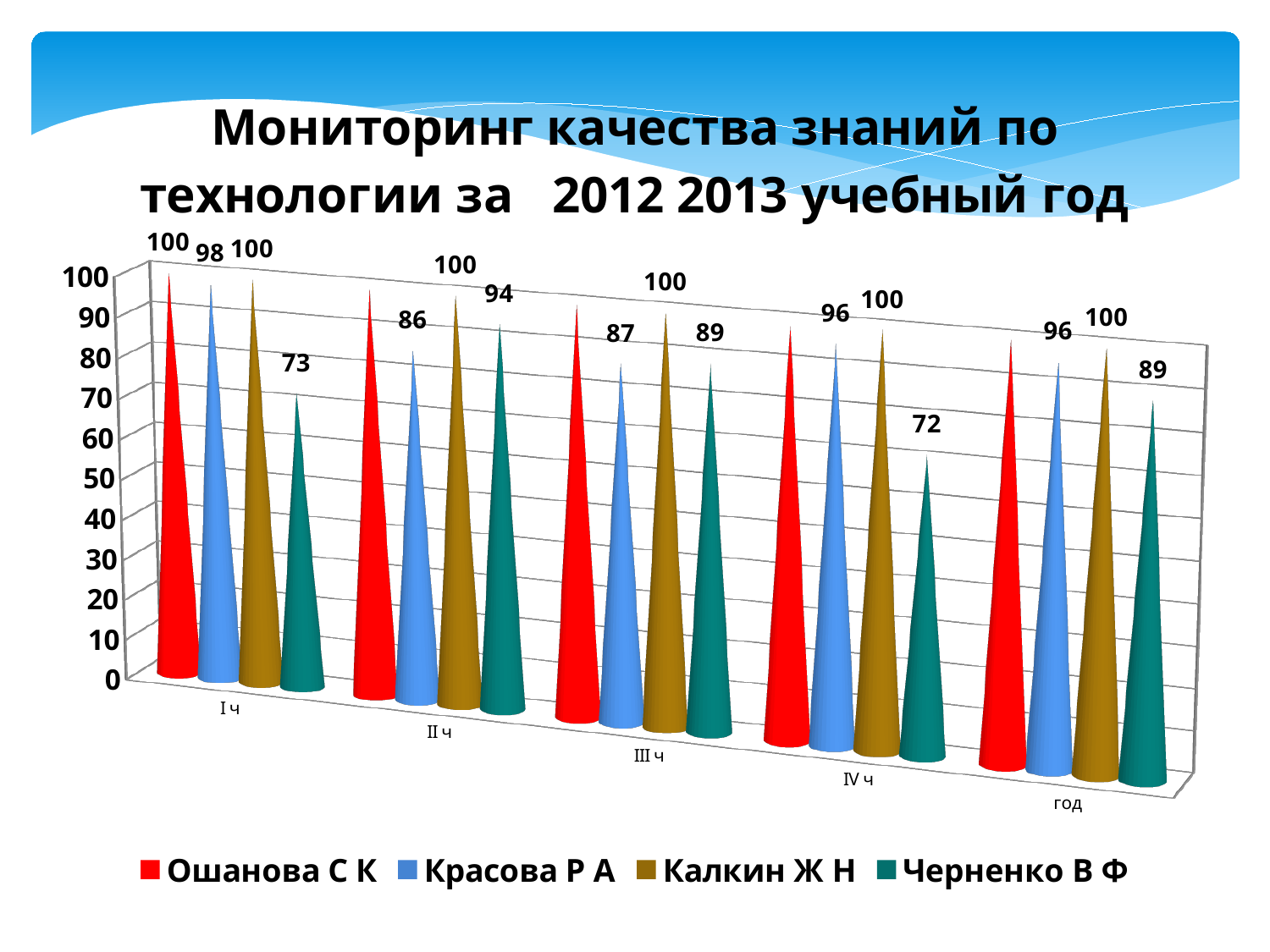
What is the value for Черненко В Ф in I ч? 73 Is the value for Красова Р А larger in III ч or in IV ч? IV ч What is the value for Красова Р А in II ч? 86 Which series has the lowest value in I ч? Черненко В Ф How many categories are shown on the x axis? 5 What kind of chart is shown on the slide? bar chart How many series does the legend list? 4 What is the value for Красова Р А in год? 96 By how much does the value for Красова Р А in I ч exceed its value in II ч? 12 What is the value for Черненко В Ф in IV ч? 72 What is the value for Калкин Ж Н in III ч? 100 What is the difference between Калкин Ж Н and Черненко В Ф in IV ч? 28